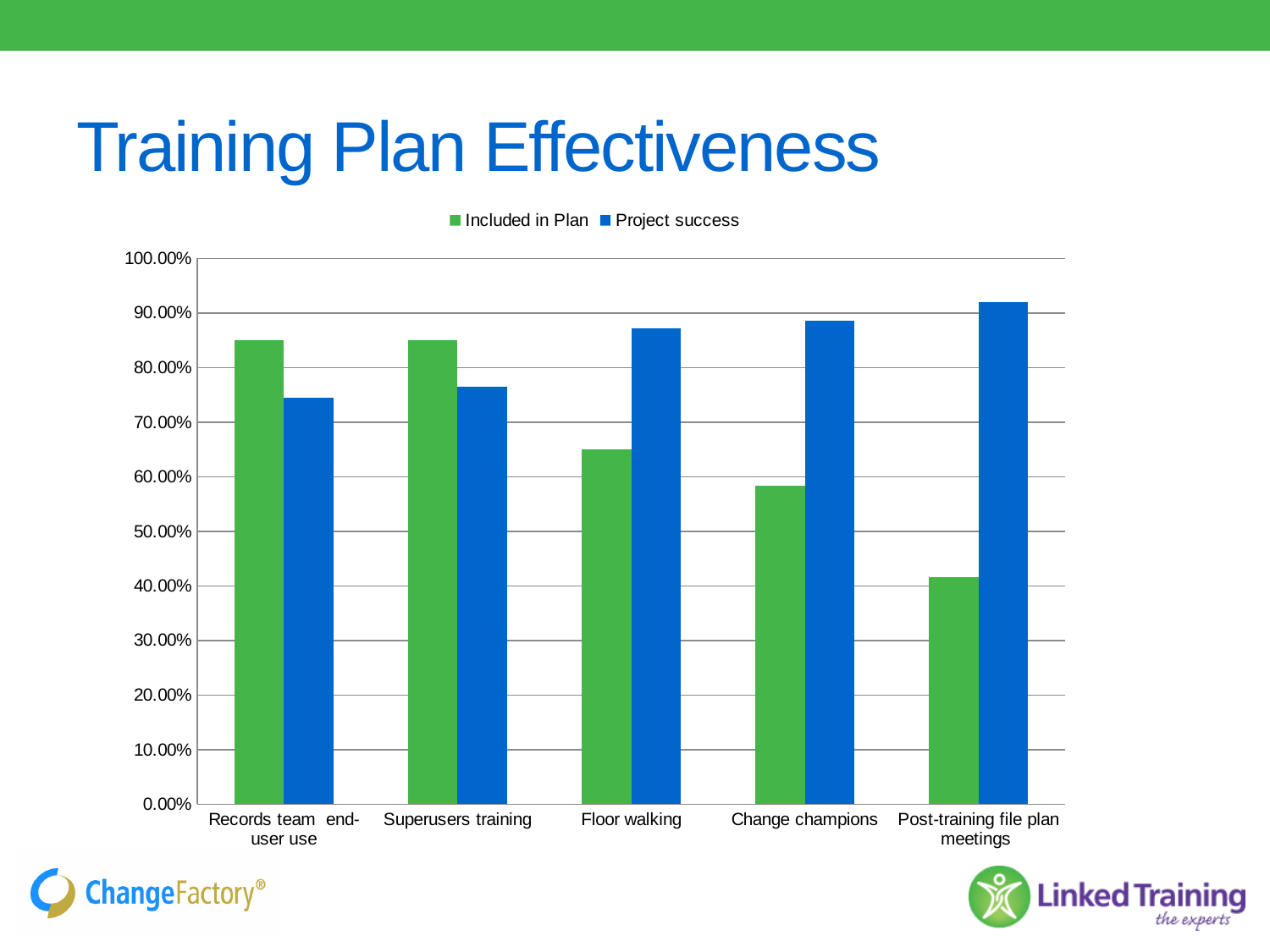
Which category has the highest value for Project success? Post-training file plan meetings Is the Project success value for Change champions greater or less than 80.00%? greater What is the title of the chart? Training Plan Effectiveness Is the Included in Plan value for Post-training file plan meetings greater or less than 50.00%? less Is the Included in Plan value for Floor walking greater or less than 60.00%? greater Do the Included in Plan values rise or fall from left to right across the categories? fall How many series does the legend list? 2 For Floor walking, which is larger: Included in Plan or Project success? Project success Which category has the lowest value for Included in Plan? Post-training file plan meetings How many categories are shown on the x axis? 5 What kind of chart is shown on the slide? bar chart